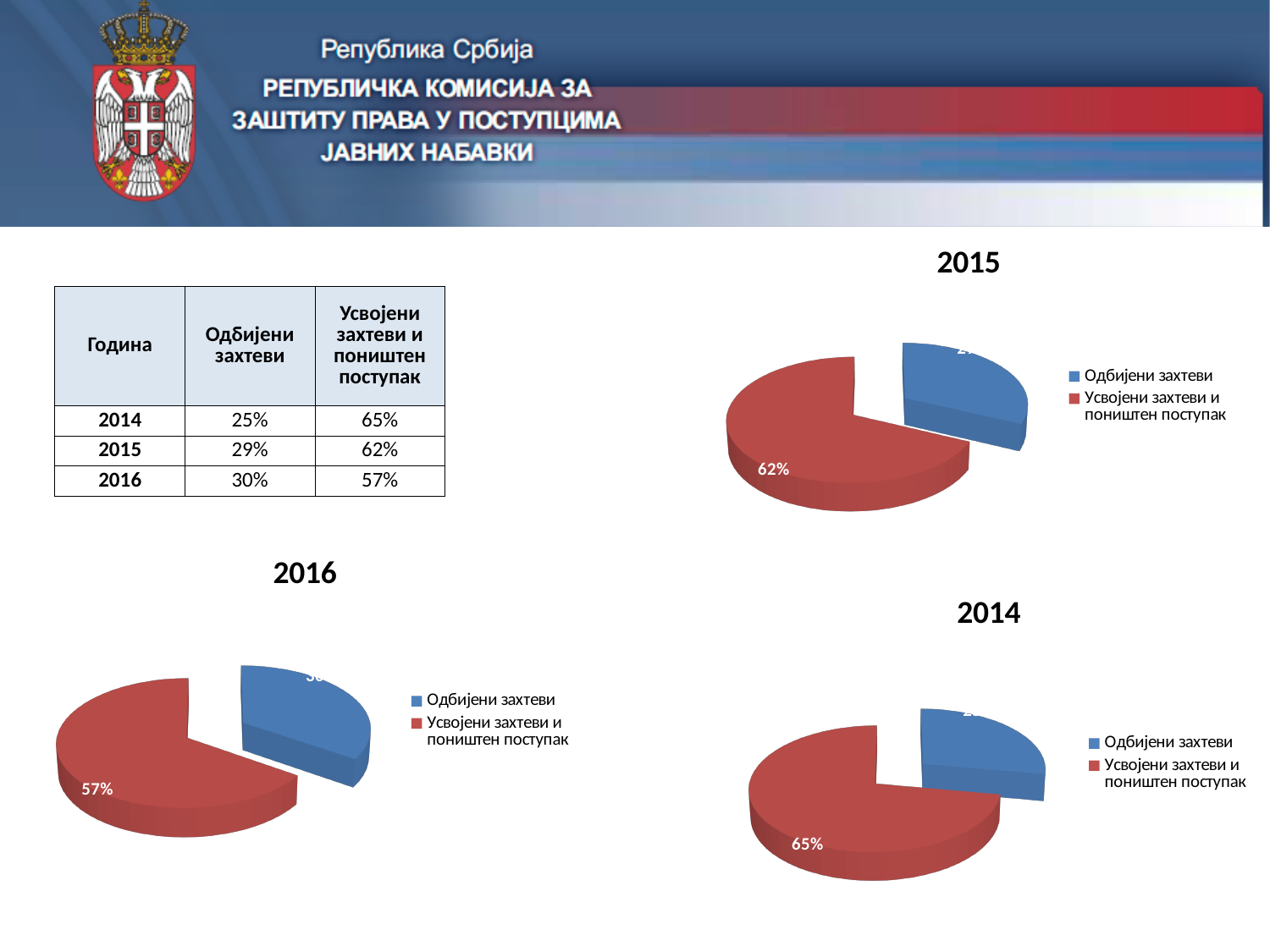
In the pie chart titled 2016, which slice is larger: Одбијени захтеви or Усвојени захтеви и поништен поступак? Усвојени захтеви и поништен поступак How many entries does the legend of the chart titled 2014 list? 2 In the pie chart titled 2015, what is the value shown for Усвојени захтеви и поништен поступак? 62% What is the difference between the Усвојени захтеви и поништен поступак share in the 2014 chart and in the 2015 chart? 3 percentage points How many slices does the pie chart titled 2016 have? 2 What kind of chart is the chart titled 2015? pie chart In the pie chart titled 2015, which category has the smallest slice? Одбијени захтеви In the pie chart titled 2016, what colour is the slice for Одбијени захтеви? blue In the pie chart titled 2014, which category has the largest slice? Усвојени захтеви и поништен поступак What is the title of the pie chart in the bottom-left part of the slide? 2016 In the pie chart titled 2014, what is the value shown for Усвојени захтеви и поништен поступак? 65% In the pie chart titled 2016, what is the value shown for Усвојени захтеви и поништен поступак? 57%